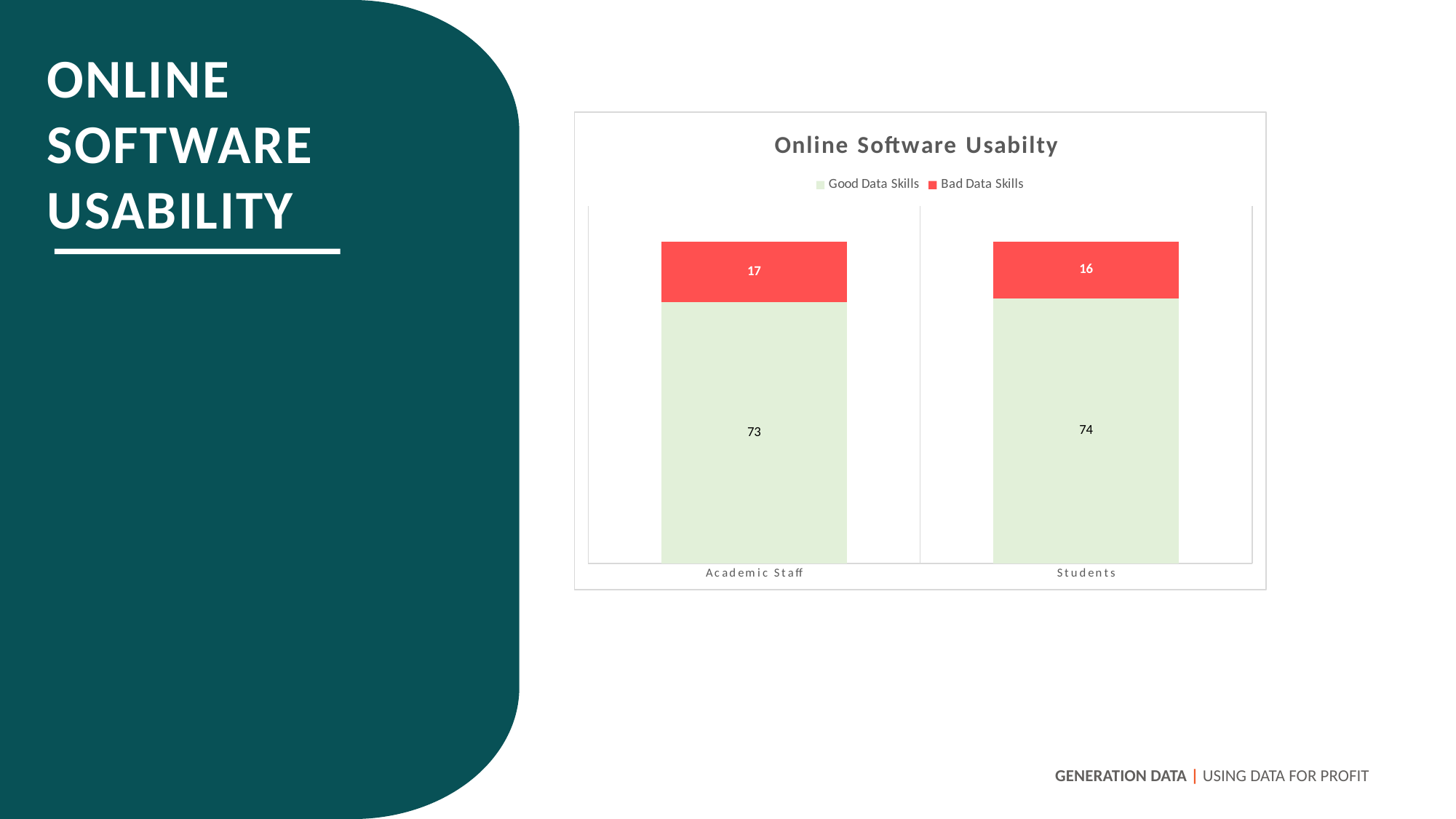
What is the difference between the Good Data Skills and Bad Data Skills values for Academic Staff? 56 What is the Bad Data Skills value for Academic Staff? 17 How many categories are shown on the x axis? 2 What is the total of the stacked bar for Students? 90 What kind of chart is shown? Stacked bar chart What is the Bad Data Skills value for Students? 16 How many series does the legend list? 2 What is the title of the chart? Online Software Usabilty What is the Good Data Skills value for Students? 74 What is the total of the stacked bar for Academic Staff? 90 What is the Good Data Skills value for Academic Staff? 73 What is the difference between the Good Data Skills values for Students and Academic Staff? 1